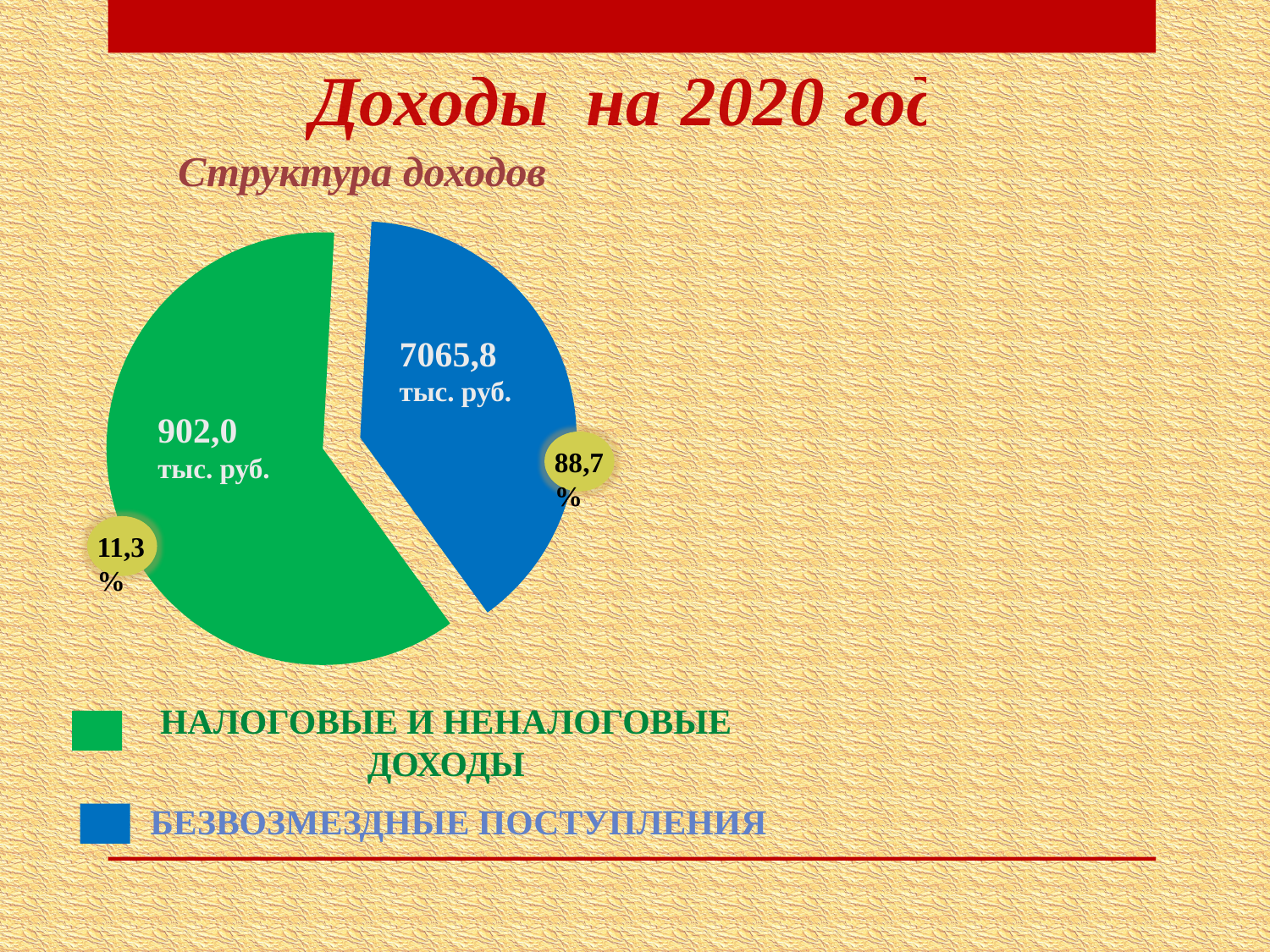
What is the title of the chart? Структура доходов What percentage share is labelled for НАЛОГОВЫЕ И НЕНАЛОГОВЫЕ ДОХОДЫ? 11,3 % What is the total of the two labelled values in the pie chart? 7967,8 тыс. руб. How many slices does the pie chart have? 2 What is the value labelled on the green slice (НАЛОГОВЫЕ И НЕНАЛОГОВЫЕ ДОХОДЫ)? 902,0 тыс. руб. Which colour represents БЕЗВОЗМЕЗДНЫЕ ПОСТУПЛЕНИЯ in the legend? blue What kind of chart is shown on the slide? pie chart What is the value labelled on the blue slice (БЕЗВОЗМЕЗДНЫЕ ПОСТУПЛЕНИЯ)? 7065,8 тыс. руб. What percentage share is labelled for БЕЗВОЗМЕЗДНЫЕ ПОСТУПЛЕНИЯ? 88,7 % How many entries does the legend list? 2 What is the difference between the labelled values for БЕЗВОЗМЕЗДНЫЕ ПОСТУПЛЕНИЯ and НАЛОГОВЫЕ И НЕНАЛОГОВЫЕ ДОХОДЫ? 6163,8 тыс. руб.